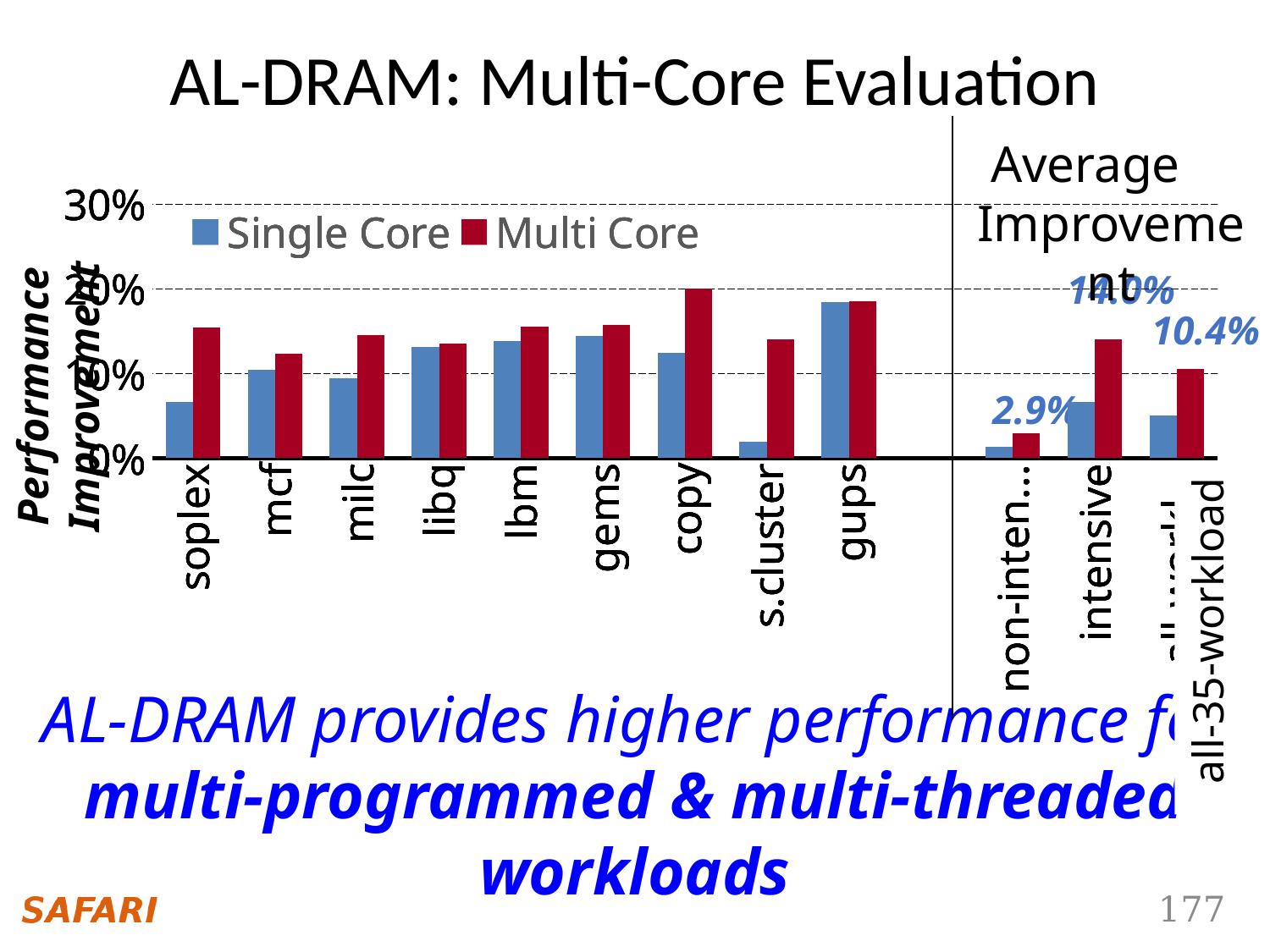
What average improvement value is labelled for the non-intensive workloads? 2.9% Is the Multi Core value for gups greater or less than 10%? greater Is the Single Core value for soplex greater or less than 10%? less How many series does the legend list? 2 What colour are the Multi Core bars? red For soplex, which is larger: the Single Core or the Multi Core performance improvement? Multi Core What are the two series named in the legend? Single Core and Multi Core What average improvement value is labelled for the all-workload category? 10.4% What kind of chart is shown on the slide? bar chart Which benchmark has the lowest Single Core performance improvement? s.cluster How many benchmark categories are plotted to the left of the vertical divider line? 9 Which benchmark has the highest Single Core performance improvement? gups